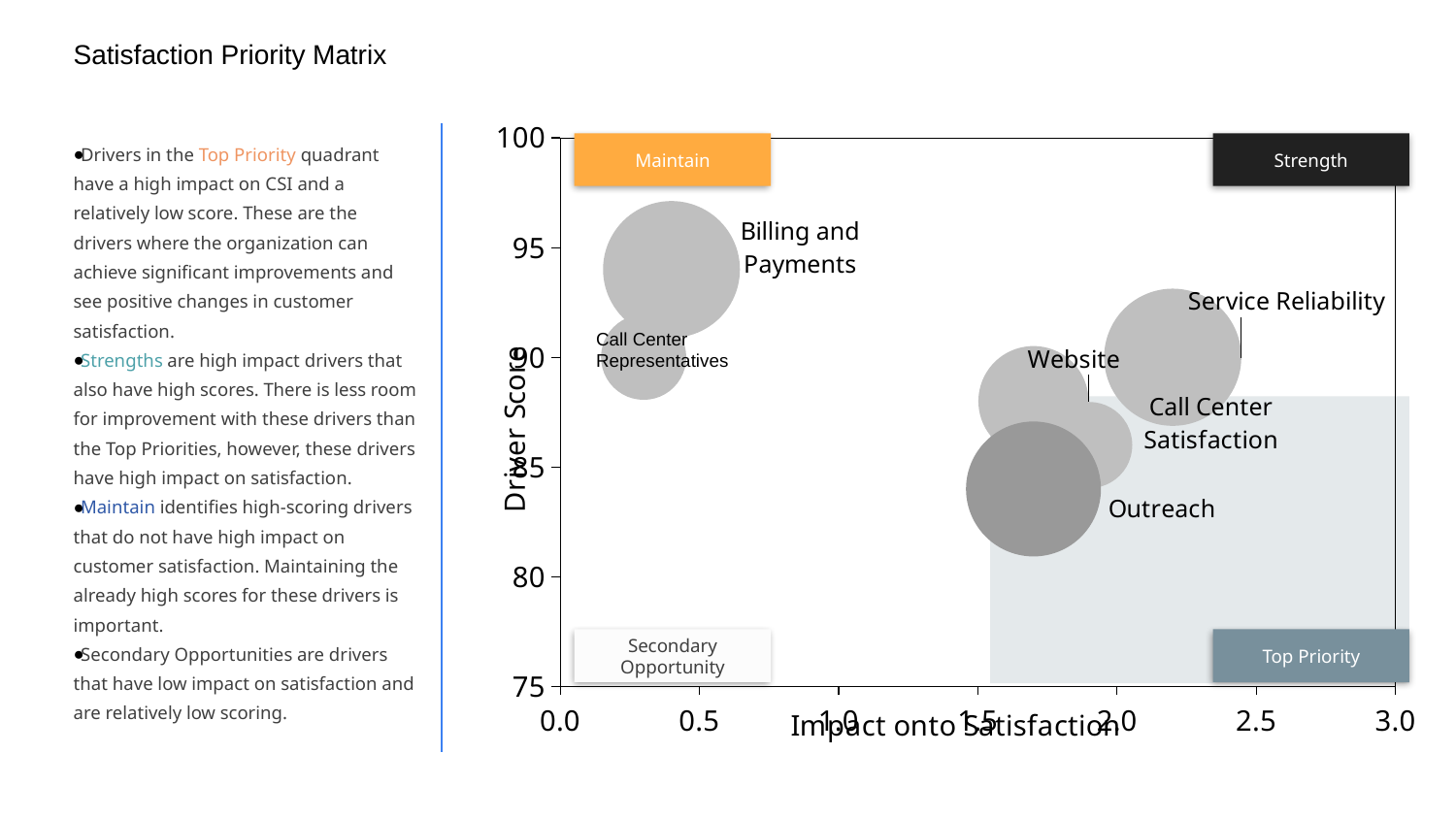
Is the Driver Score for Billing and Payments greater or less than 90? greater Which driver has the lowest Driver Score? Outreach What is the label of the quadrant in the top-right corner of the chart? Strength How many drivers (bubbles) are plotted on the chart? 6 Which driver has the highest Impact onto Satisfaction? Service Reliability Which has a higher Driver Score, Billing and Payments or Website? Billing and Payments Which driver has the highest Driver Score? Billing and Payments What kind of chart is shown on the slide? Bubble chart Is the Impact onto Satisfaction for Billing and Payments greater or less than 1.0? less Which has a higher Impact onto Satisfaction, Outreach or Service Reliability? Service Reliability Is the Impact onto Satisfaction for Service Reliability greater or less than 2.0? greater